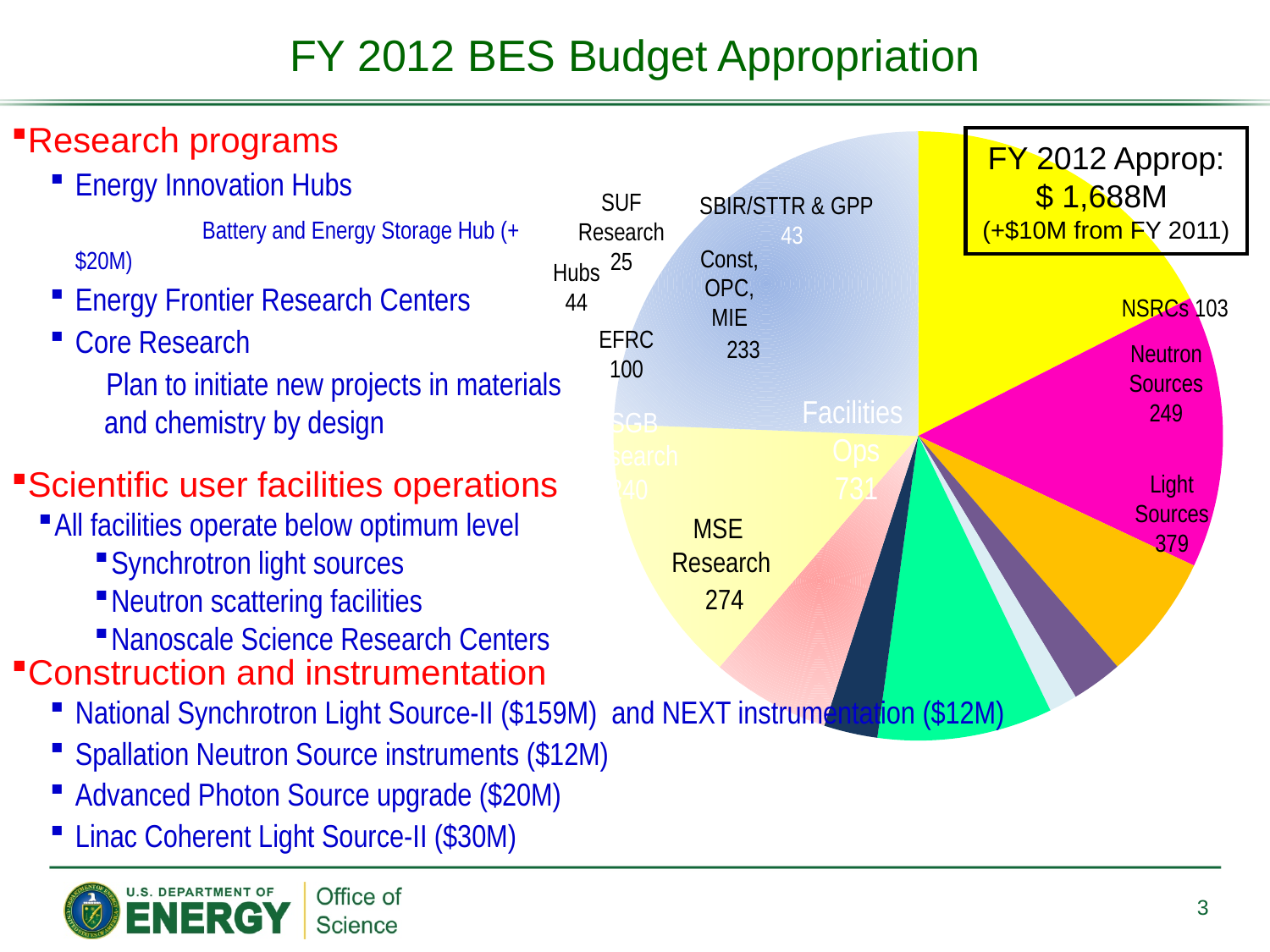
What is the value shown for Const, OPC, MIE in the pie chart? 233 What kind of chart is shown on the slide? pie chart What total FY 2012 appropriation is stated in the box next to the pie chart? $ 1,688M Which labeled slice of the pie chart has the smallest value? SUF Research What is the value shown for Neutron Sources in the pie chart? 249 What is the value shown for NSRCs in the pie chart? 103 What is the value shown for Hubs in the pie chart? 44 What is the value shown for EFRC in the pie chart? 100 What is the difference between the Light Sources value and the Neutron Sources value in the pie chart? 130 Which is larger in the pie chart, MSE Research or Const, OPC, MIE? MSE Research What is the value shown for MSE Research in the pie chart? 274 What is the value shown for Light Sources in the pie chart? 379